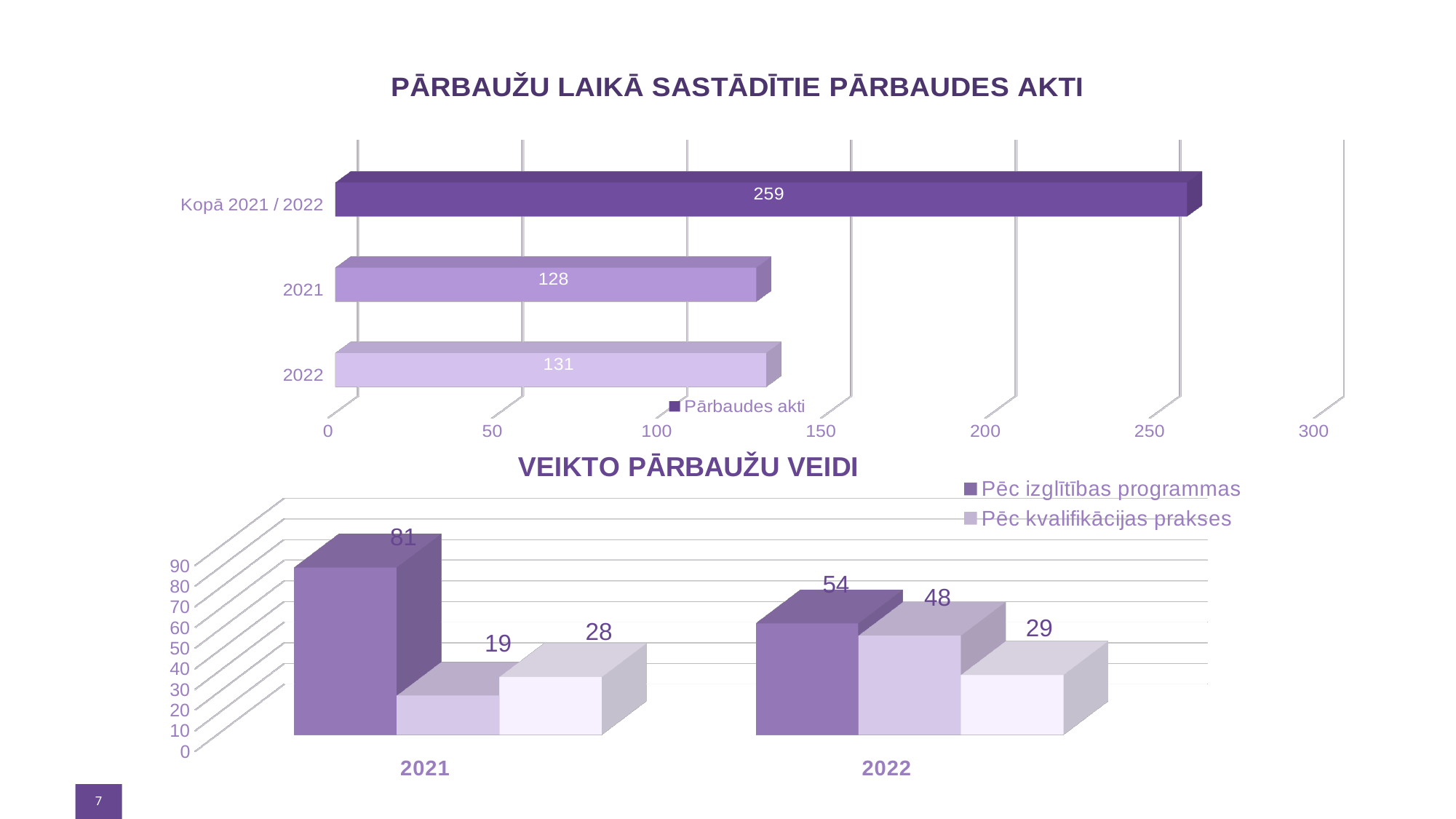
In the chart titled 'VEIKTO PĀRBAUŽU VEIDI', what is the difference between 'Pēc izglītības programmas' in 2021 and in 2022? 27 In the chart titled 'PĀRBAUŽU LAIKĀ SASTĀDĪTIE PĀRBAUDES AKTI', what is the value for 2022? 131 In the chart titled 'PĀRBAUŽU LAIKĀ SASTĀDĪTIE PĀRBAUDES AKTI', what is the value for 2021? 128 In the chart titled 'VEIKTO PĀRBAUŽU VEIDI', what is the value for 'Pēc izglītības programmas' in 2021? 81 In the chart titled 'PĀRBAUŽU LAIKĀ SASTĀDĪTIE PĀRBAUDES AKTI', which category has the lowest value? 2021 In the chart titled 'VEIKTO PĀRBAUŽU VEIDI', what is the value for 'Pēc kvalifikācijas prakses' in 2022? 48 In the chart titled 'PĀRBAUŽU LAIKĀ SASTĀDĪTIE PĀRBAUDES AKTI', how many categories are plotted? 3 In the chart titled 'PĀRBAUŽU LAIKĀ SASTĀDĪTIE PĀRBAUDES AKTI', what is the difference between the 2022 value and the 2021 value? 3 In the chart titled 'VEIKTO PĀRBAUŽU VEIDI', how many series does the legend list? 2 In the chart titled 'VEIKTO PĀRBAUŽU VEIDI', which is larger: 'Pēc kvalifikācijas prakses' in 2021 or in 2022? 2022 In the chart titled 'PĀRBAUŽU LAIKĀ SASTĀDĪTIE PĀRBAUDES AKTI', what is the value for 'Kopā 2021 / 2022'? 259 In the chart titled 'PĀRBAUŽU LAIKĀ SASTĀDĪTIE PĀRBAUDES AKTI', what type of chart is shown? Bar chart